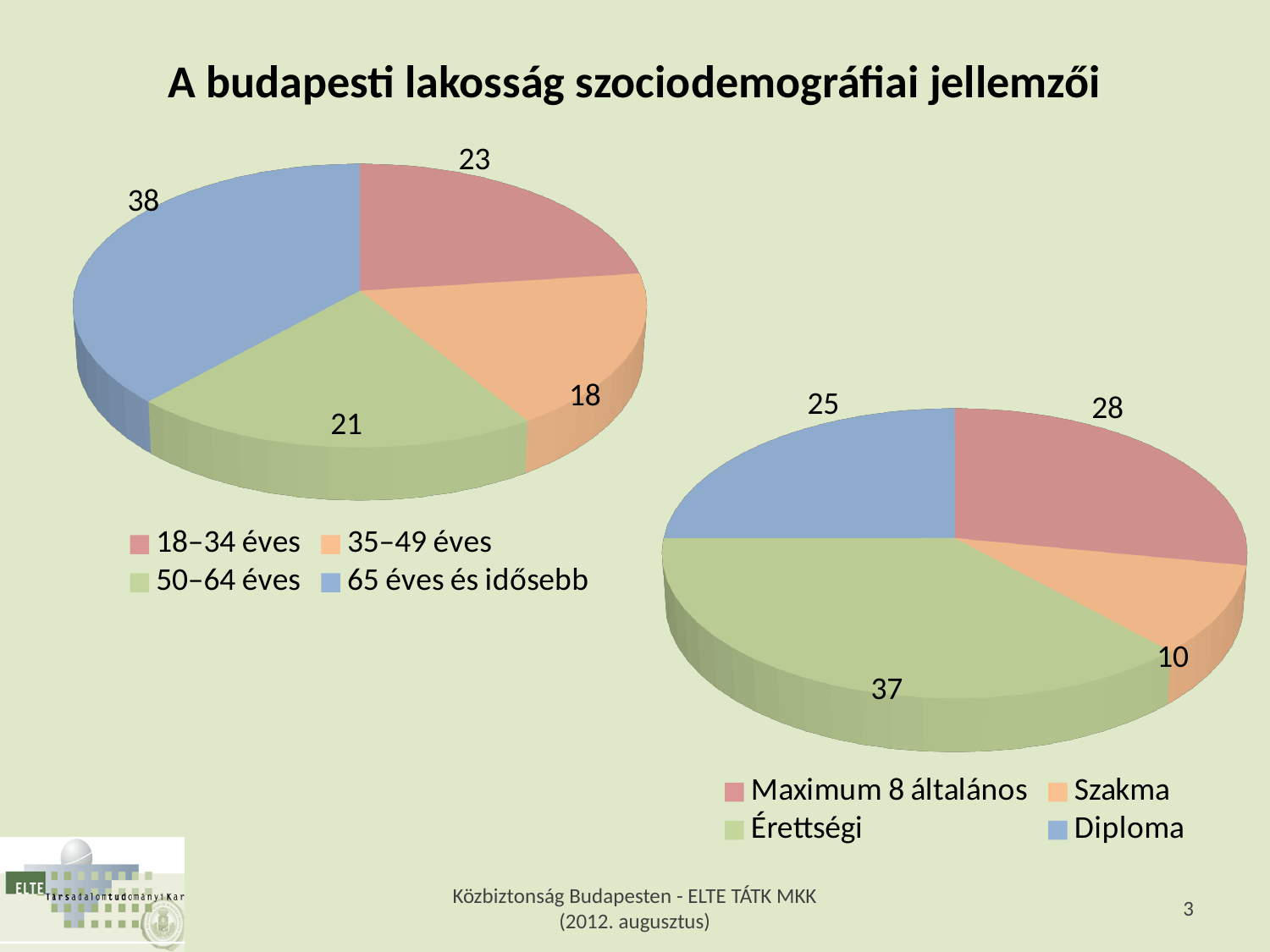
In the pie chart on the left, what is the difference between the 65 éves és idősebb value and the 18–34 éves value? 15 In the pie chart on the right, what is the value for the Szakma slice? 10 In the pie chart on the left, which category has the smallest slice? 35–49 éves In the pie chart on the right, which is larger, Maximum 8 általános or Diploma? Maximum 8 általános In the pie chart on the right, what is the difference between the Érettségi value and the Diploma value? 12 In the pie chart on the right, which category has the smallest slice? Szakma What type of chart is shown on the right of the slide? Pie chart In the pie chart on the left, how many slices does the pie have? 4 In the pie chart on the left, what is the value for the 35–49 éves slice? 18 In the pie chart on the left, what is the value for the 65 éves és idősebb slice? 38 In the pie chart on the right, what is the value for the Érettségi slice? 37 In the pie chart on the left, which category has the largest slice? 65 éves és idősebb